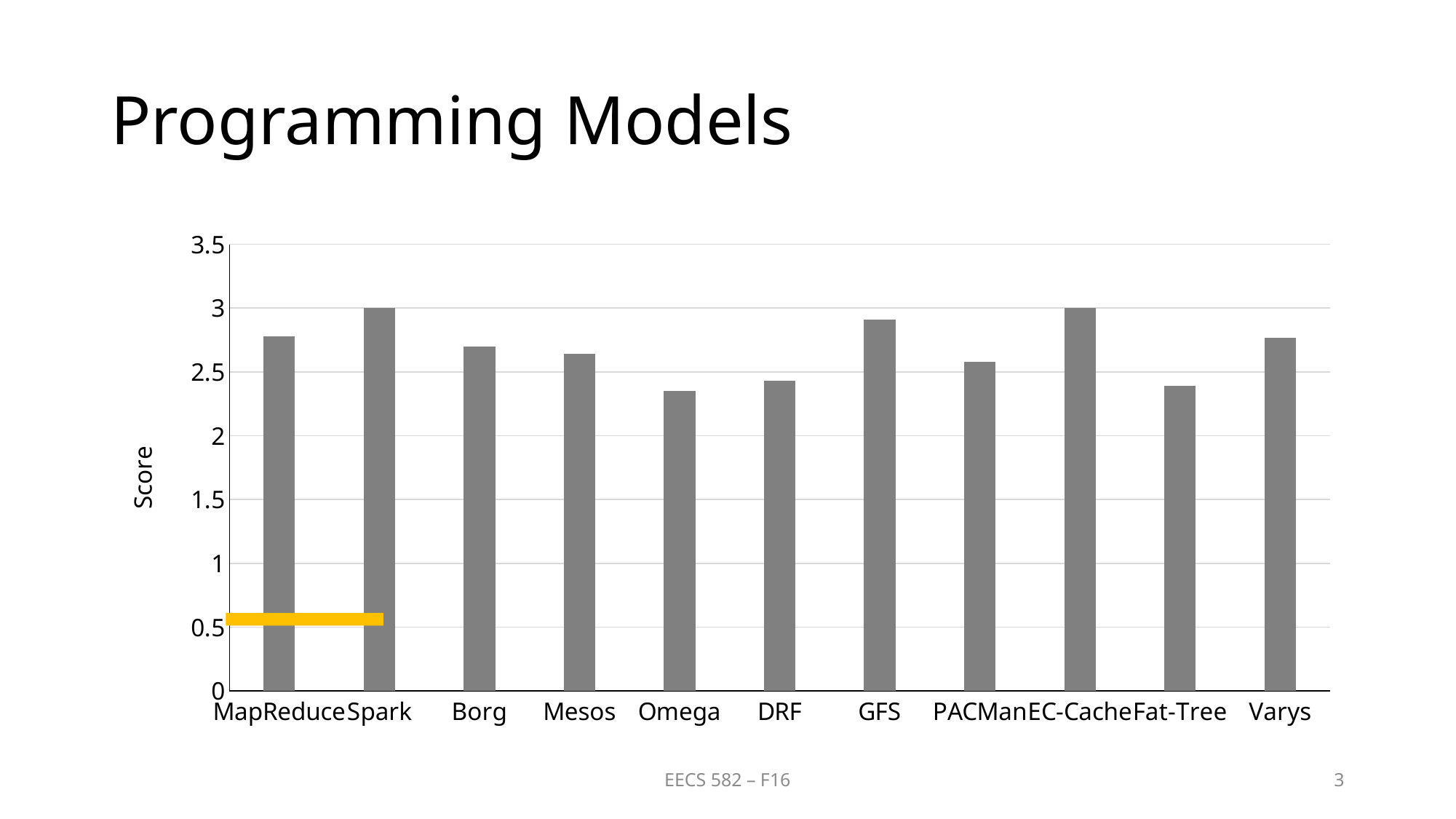
Which has the larger score, Spark or Omega? Spark How many categories are plotted on the x axis of the chart? 11 What is the label of the vertical axis? Score Is the value for GFS greater or less than 2.5? greater What is the score for EC-Cache? 3 What is the title of the chart slide? Programming Models Which has the larger score, GFS or DRF? GFS Is the value for MapReduce greater or less than 2.5? greater What kind of chart is shown on the slide? bar chart What is the score for Spark? 3 Is the value for Omega greater or less than 2.5? less